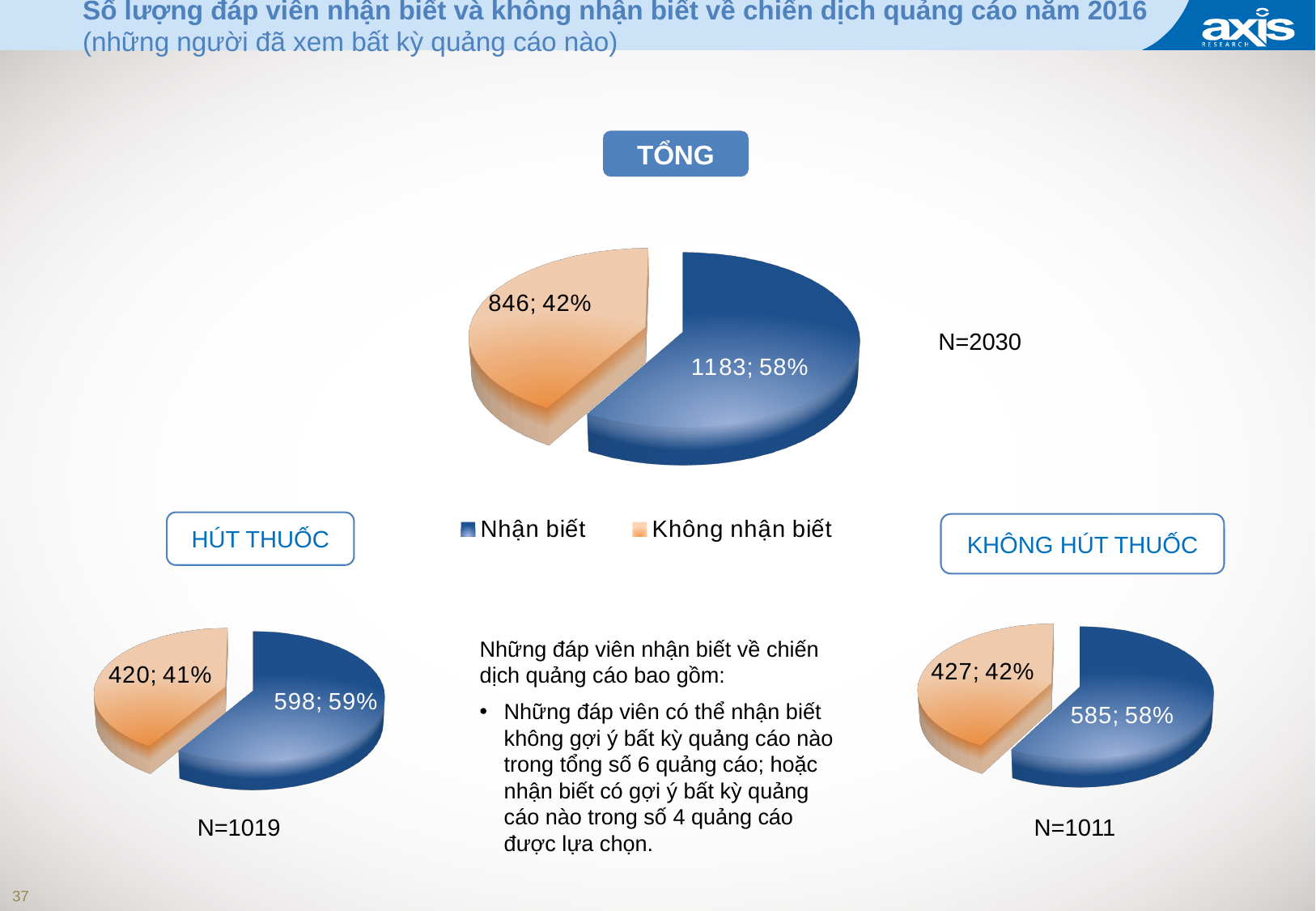
In the TỔNG pie chart, what share of the pie does Không nhận biết take? 42% What is the N value shown next to the KHÔNG HÚT THUỐC pie chart? N=1011 How many series does the legend list? 2 In the TỔNG pie chart, what is the difference between the Nhận biết count and the Không nhận biết count? 337 In the HÚT THUỐC pie chart, what is the difference between the Nhận biết count and the Không nhận biết count? 178 In the HÚT THUỐC pie chart, what share of the pie does Nhận biết take? 59% In the TỔNG pie chart, what is the value shown for Không nhận biết? 846; 42% In the KHÔNG HÚT THUỐC pie chart, which slice is larger, Nhận biết or Không nhận biết? Nhận biết In the TỔNG pie chart, what is the value shown for Nhận biết? 1183; 58% In the KHÔNG HÚT THUỐC pie chart, what is the value shown for Không nhận biết? 427; 42% What kind of chart is the TỔNG chart? Pie chart In the HÚT THUỐC pie chart, what is the value shown for Nhận biết? 598; 59%